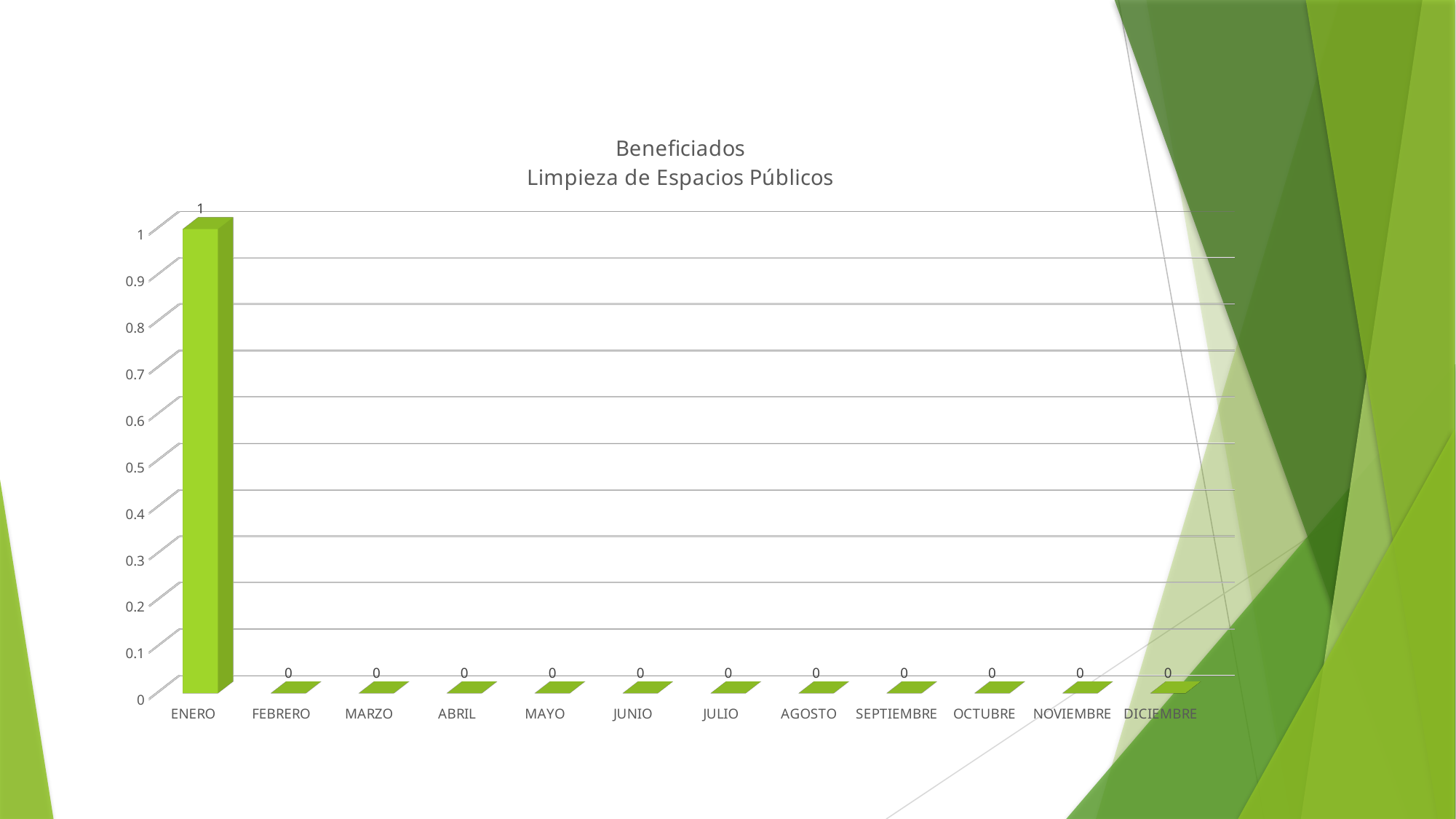
Which month has the highest value? ENERO What kind of chart is shown? bar chart How many months have a value of 0? 11 Which is larger, the value for ENERO or the value for MAYO? ENERO What is the difference between the values for ENERO and FEBRERO? 1 What is the value for ENERO? 1 What is the total of all the values shown in the chart? 1 What is the title of the chart? Beneficiados Limpieza de Espacios Públicos What is the highest value shown on the y axis? 1 How many months are shown on the x axis? 12 What is the value for JULIO? 0 What is the value for DICIEMBRE? 0